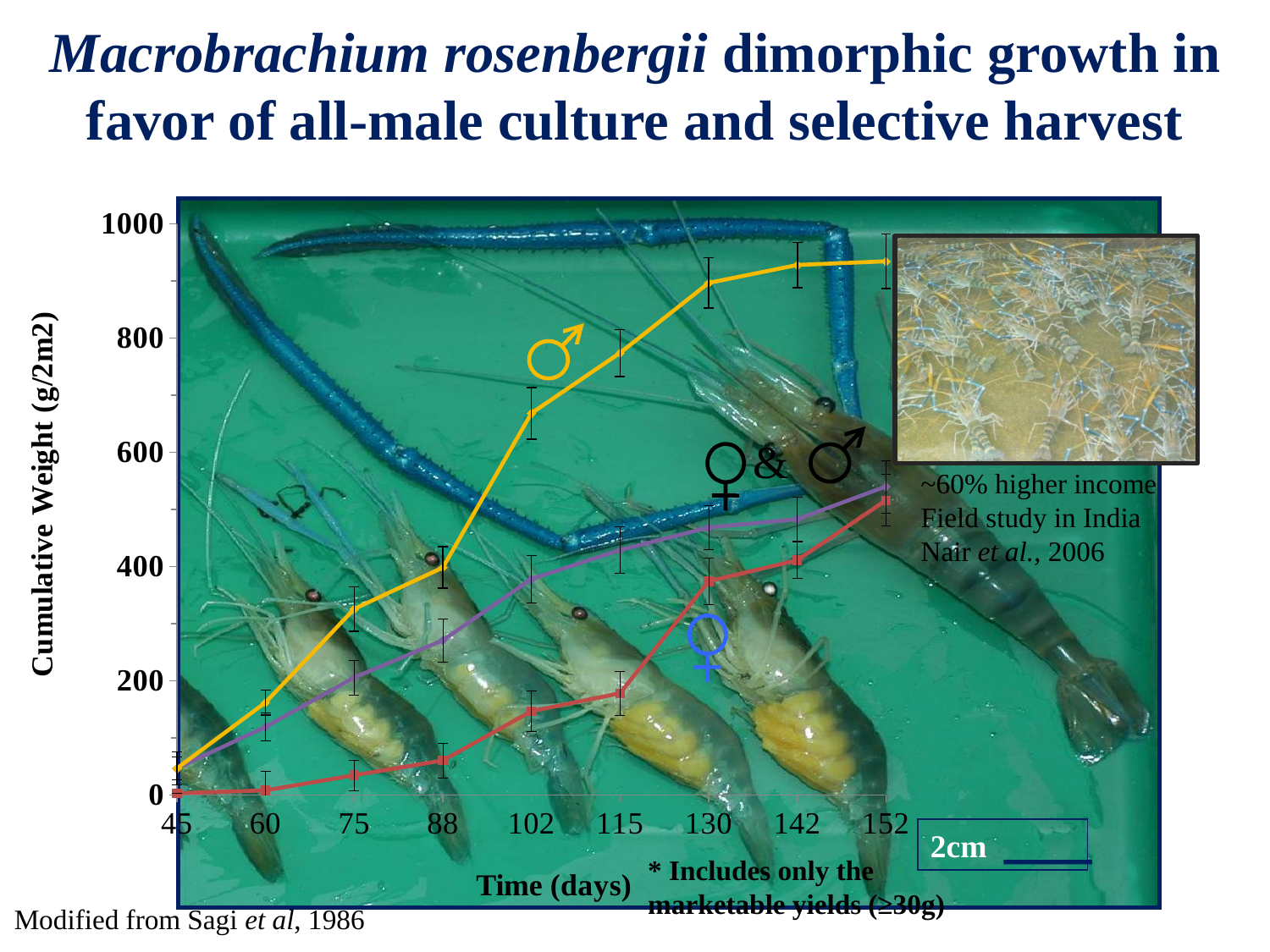
What is the label of the x axis of the chart? Time (days) Does the male (♂) line rise or fall as time increases along the x axis? rise Which line has the highest value at 152 days? male (♂) How many time points are marked along the x axis of the chart? 9 What kind of chart is shown on the slide? line chart Is the value of the female (♀) line at 88 days greater or less than 200? less Is the value of the male (♂) line at 102 days greater or less than 600? greater Is the value of the male (♂) line at 152 days greater or less than 800? greater At 130 days, which line has the larger value: the male (♂) line or the female (♀) line? male (♂) How many lines (series) are plotted on the chart? 3